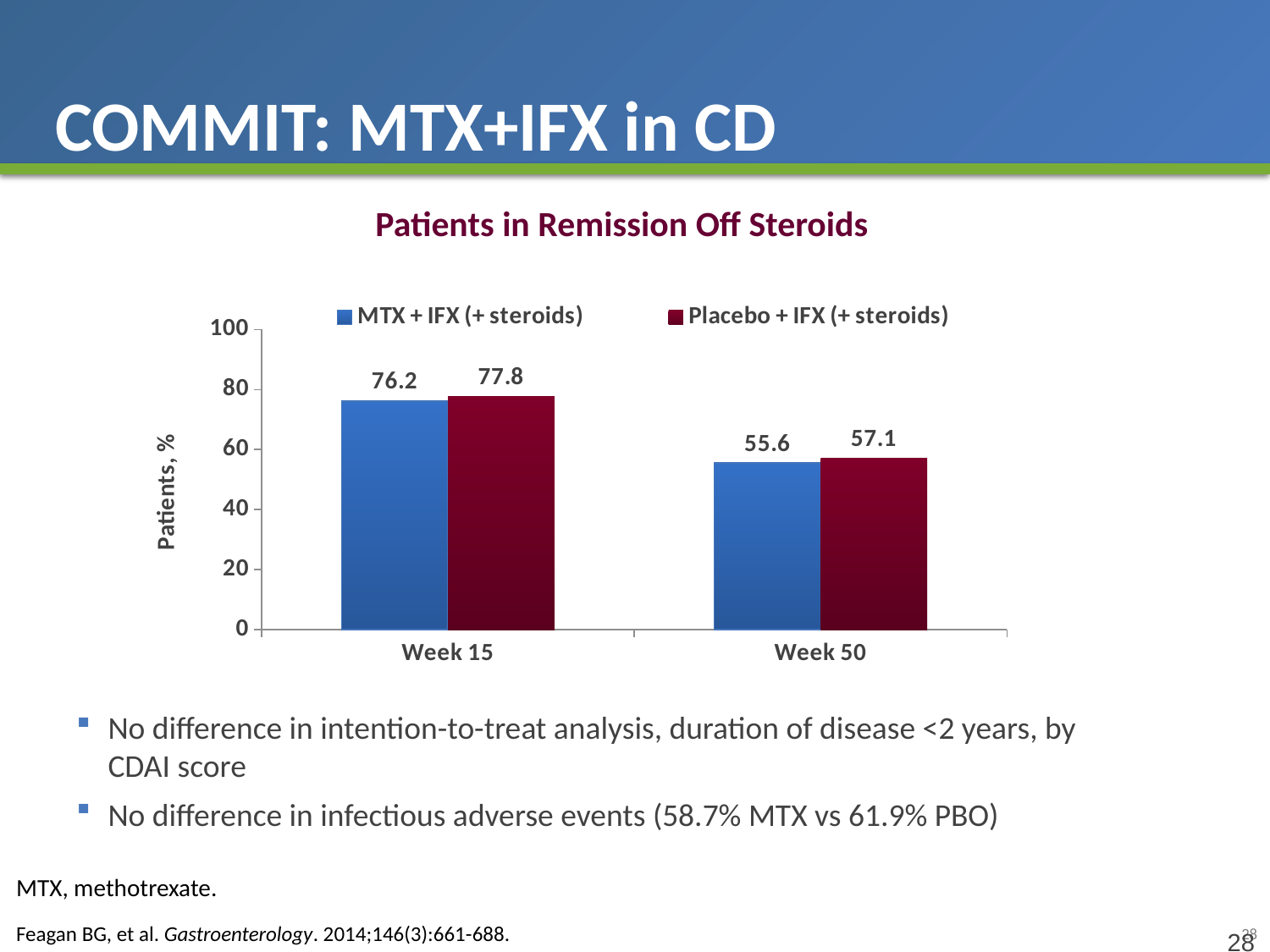
Is the value for MTX + IFX (+ steroids) at Week 50 greater or less than 60? less What kind of chart is shown on the slide? Bar chart What is the value for Placebo + IFX (+ steroids) at Week 50? 57.1 Which series has the lowest value at Week 50? MTX + IFX (+ steroids) How many series does the legend list? 2 What is the difference between the Placebo + IFX (+ steroids) and MTX + IFX (+ steroids) values at Week 15? 1.6 What is the value for Placebo + IFX (+ steroids) at Week 15? 77.8 What is the difference between the MTX + IFX (+ steroids) values at Week 15 and Week 50? 20.6 Do the values for MTX + IFX (+ steroids) rise or fall from Week 15 to Week 50? Fall What is the value for MTX + IFX (+ steroids) at Week 50? 55.6 Which series has the highest value at Week 15? Placebo + IFX (+ steroids) What is the value for MTX + IFX (+ steroids) at Week 15? 76.2